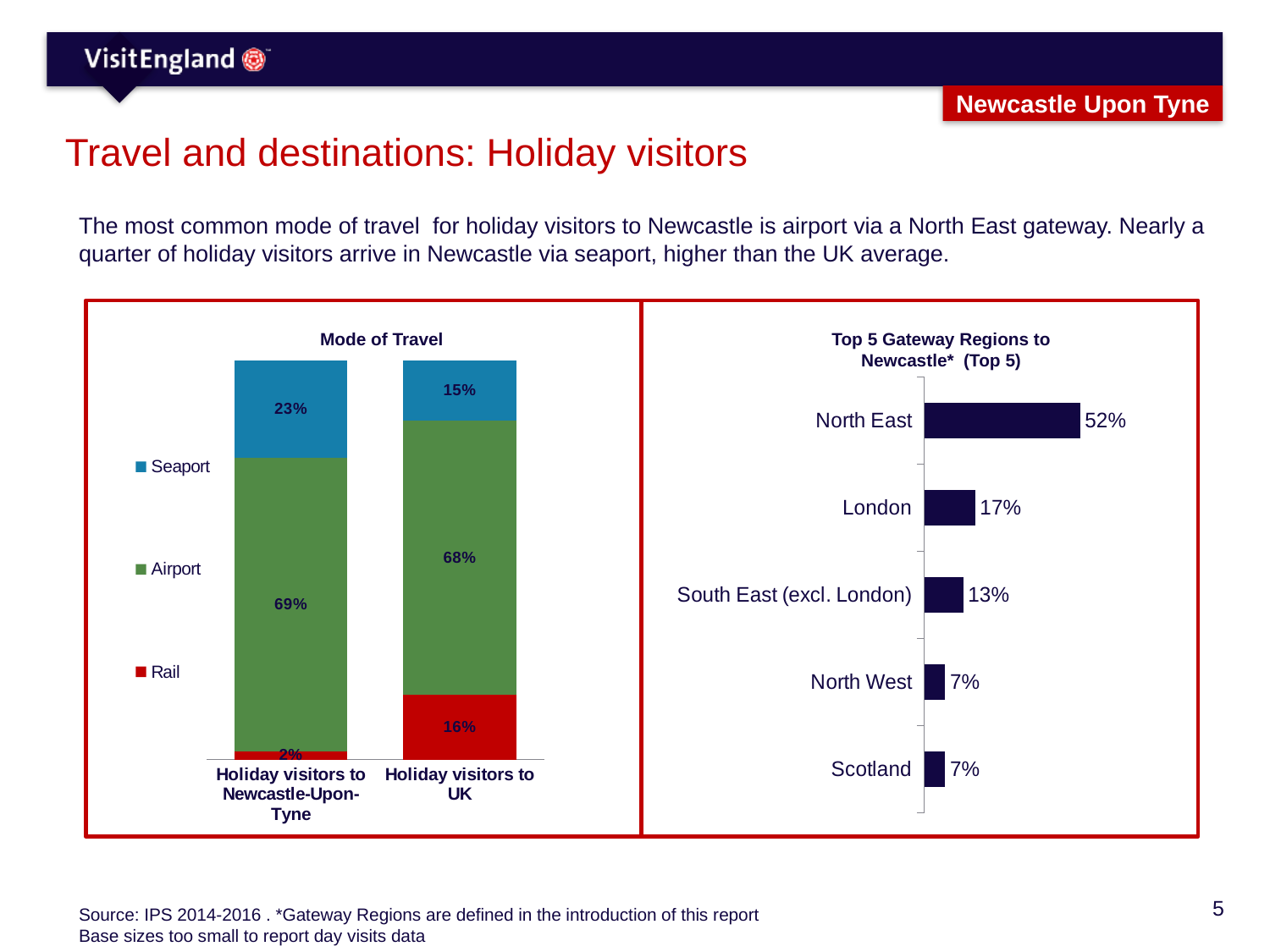
In the 'Top 5 Gateway Regions to Newcastle' chart, how many regions are shown? 5 In the 'Mode of Travel' chart, what percentage of holiday visitors to the UK arrive by rail? 16% In the 'Mode of Travel' chart, what percentage of holiday visitors to Newcastle-Upon-Tyne arrive by airport? 69% In the 'Top 5 Gateway Regions to Newcastle' chart, what is the difference between North East and South East (excl. London)? 39 percentage points In the 'Mode of Travel' chart, what is the difference between the seaport share for holiday visitors to Newcastle-Upon-Tyne and for holiday visitors to the UK? 8 percentage points In the 'Mode of Travel' chart, what is the total of the stacked bar for holiday visitors to the UK? 99% In the 'Mode of Travel' chart, which has the larger rail share: holiday visitors to Newcastle-Upon-Tyne or holiday visitors to the UK? Holiday visitors to UK In the 'Mode of Travel' chart, how many series does the legend list? 3 In the 'Top 5 Gateway Regions to Newcastle' chart, which region has the highest value? North East In the 'Mode of Travel' chart, what percentage of holiday visitors to Newcastle-Upon-Tyne arrive by seaport? 23% In the 'Top 5 Gateway Regions to Newcastle' chart, what is the value for London? 17% What kind of chart is the 'Top 5 Gateway Regions to Newcastle' chart? Bar chart